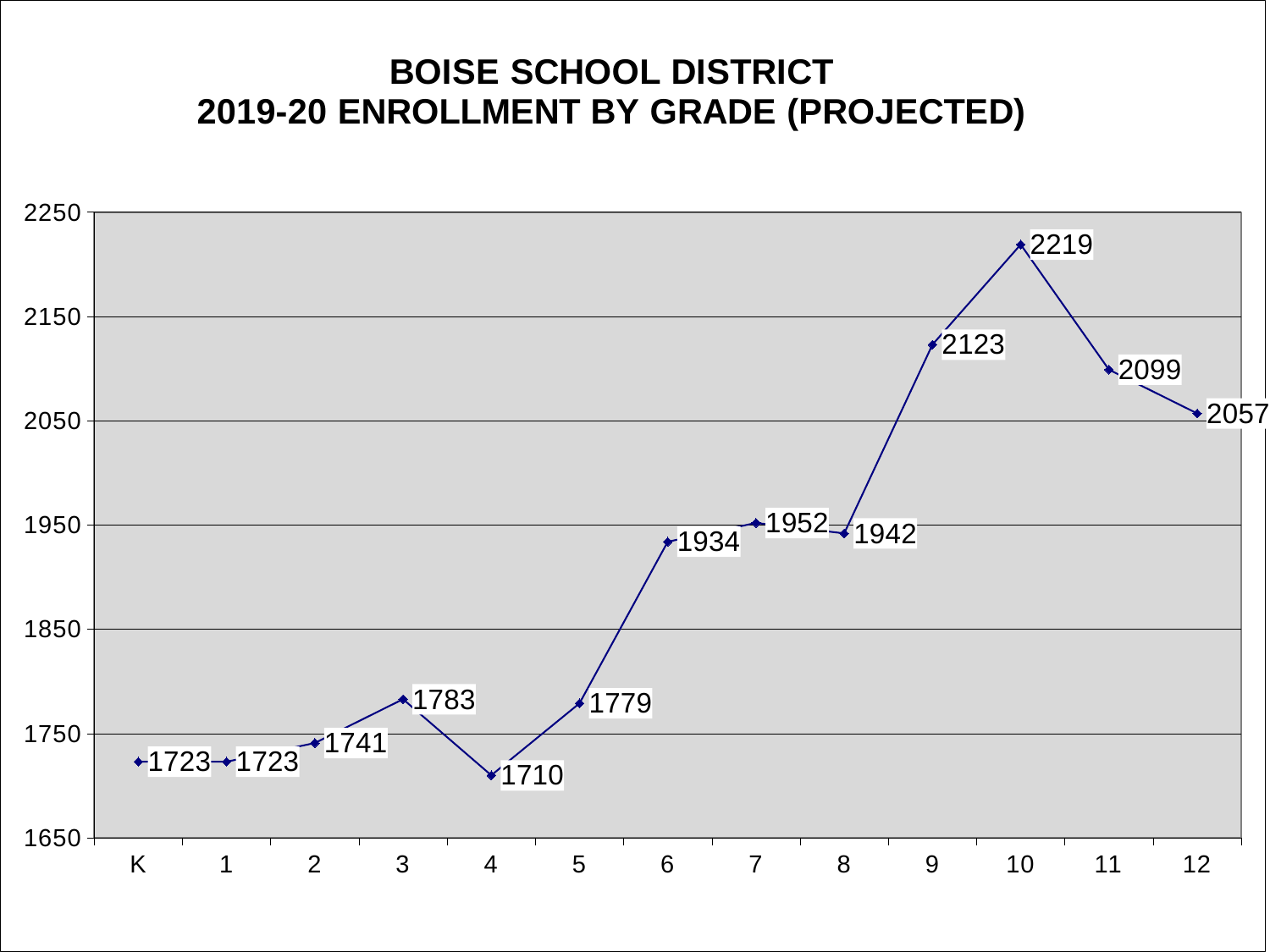
What kind of chart is shown on the slide? Line chart What is the difference in projected enrollment between grade 6 and grade 5? 155 Which has a larger projected enrollment, grade 7 or grade 8? Grade 7 Does the projected enrollment rise or fall from grade 10 to grade 12? Fall What is the projected enrollment for grade 4? 1710 What is the difference in projected enrollment between grade 10 and grade 9? 96 What is the projected enrollment for grade 10? 2219 Is the projected enrollment for grade 9 greater or less than 2050? greater Which grade has the lowest projected enrollment? 4 What is the projected enrollment for grade 12? 2057 Which grade has the highest projected enrollment? 10 How many grade levels are plotted on the chart? 13